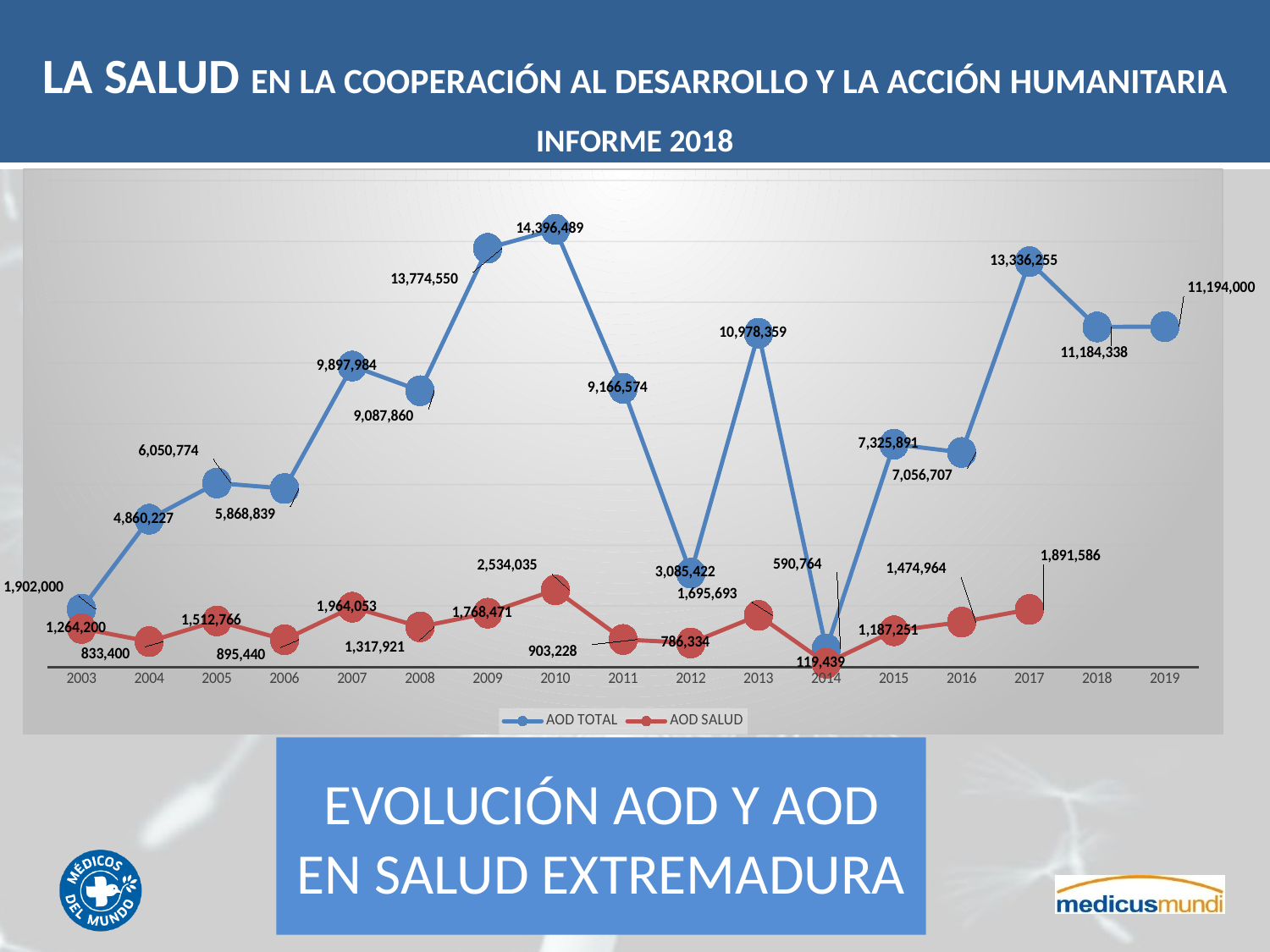
What is the AOD TOTAL value for 2017? 13,336,255 Which is larger, AOD TOTAL in 2009 or AOD TOTAL in 2011? 2009 What is the AOD TOTAL value for 2010? 14,396,489 What type of chart is shown on the slide? line chart What are the two series named in the legend? AOD TOTAL and AOD SALUD What is the AOD SALUD value for 2003? 1,264,200 What is the difference between AOD TOTAL and AOD SALUD in 2010? 11,862,454 In which year is AOD SALUD highest? 2010 In which year is AOD TOTAL highest? 2010 How many series does the legend list? 2 What is the AOD SALUD value for 2007? 1,964,053 In which year is AOD TOTAL lowest? 2014